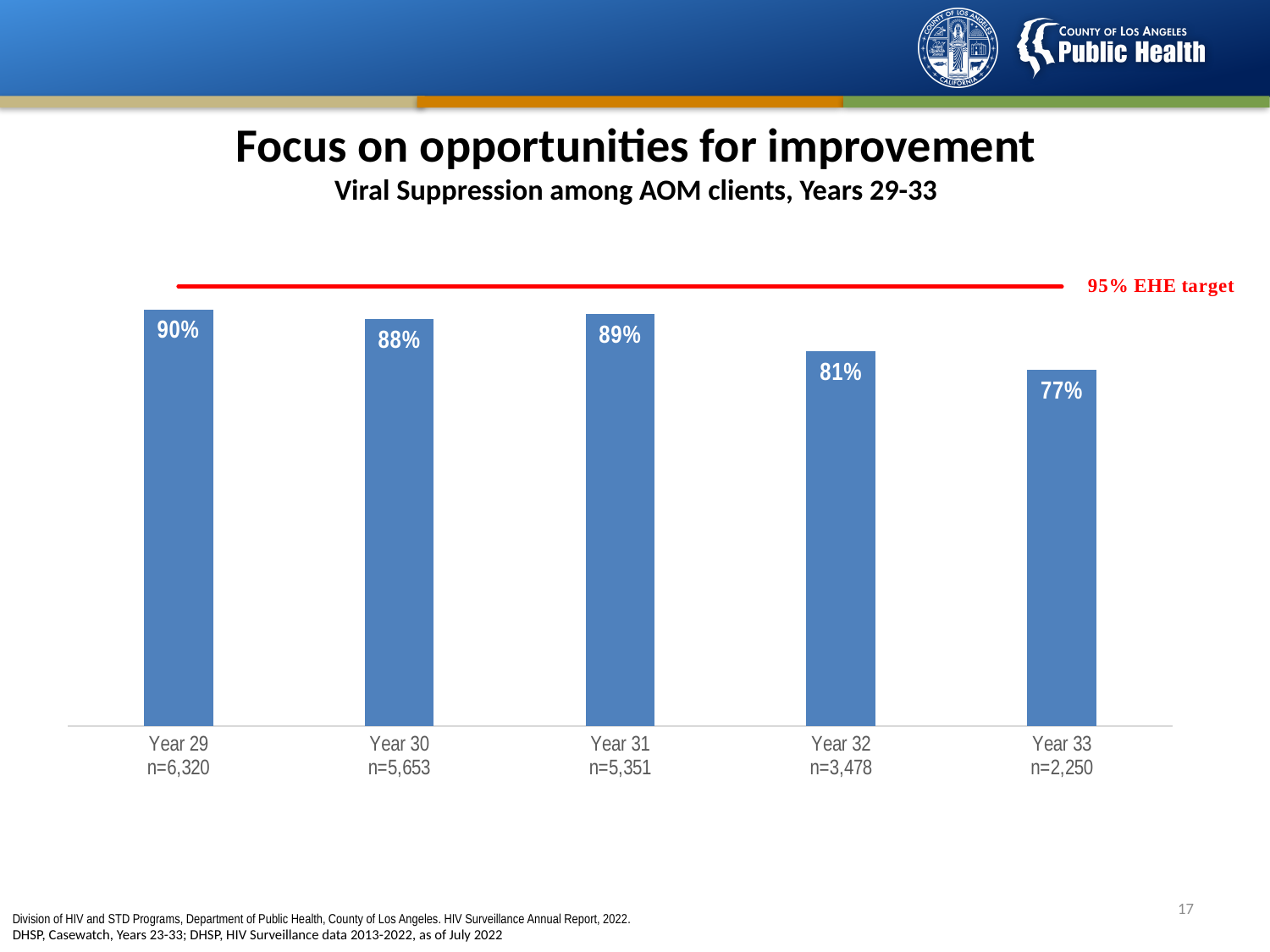
What is the viral suppression percentage for Year 33? 77% What kind of chart is shown on the slide? Bar chart Do the viral suppression percentages generally rise or fall from Year 29 to Year 33? Fall How many years (bars) are shown in the chart? 5 Which year has the highest viral suppression percentage? Year 29 What is the difference in viral suppression percentage between Year 29 and Year 33? 13% What target value does the red line on the chart represent? 95% EHE target Which year has the lowest viral suppression percentage? Year 33 What is the viral suppression percentage for Year 32? 81% What is the difference in viral suppression percentage between Year 31 and Year 32? 8% What is the viral suppression percentage for Year 29? 90% Which has a higher viral suppression percentage, Year 30 or Year 31? Year 31